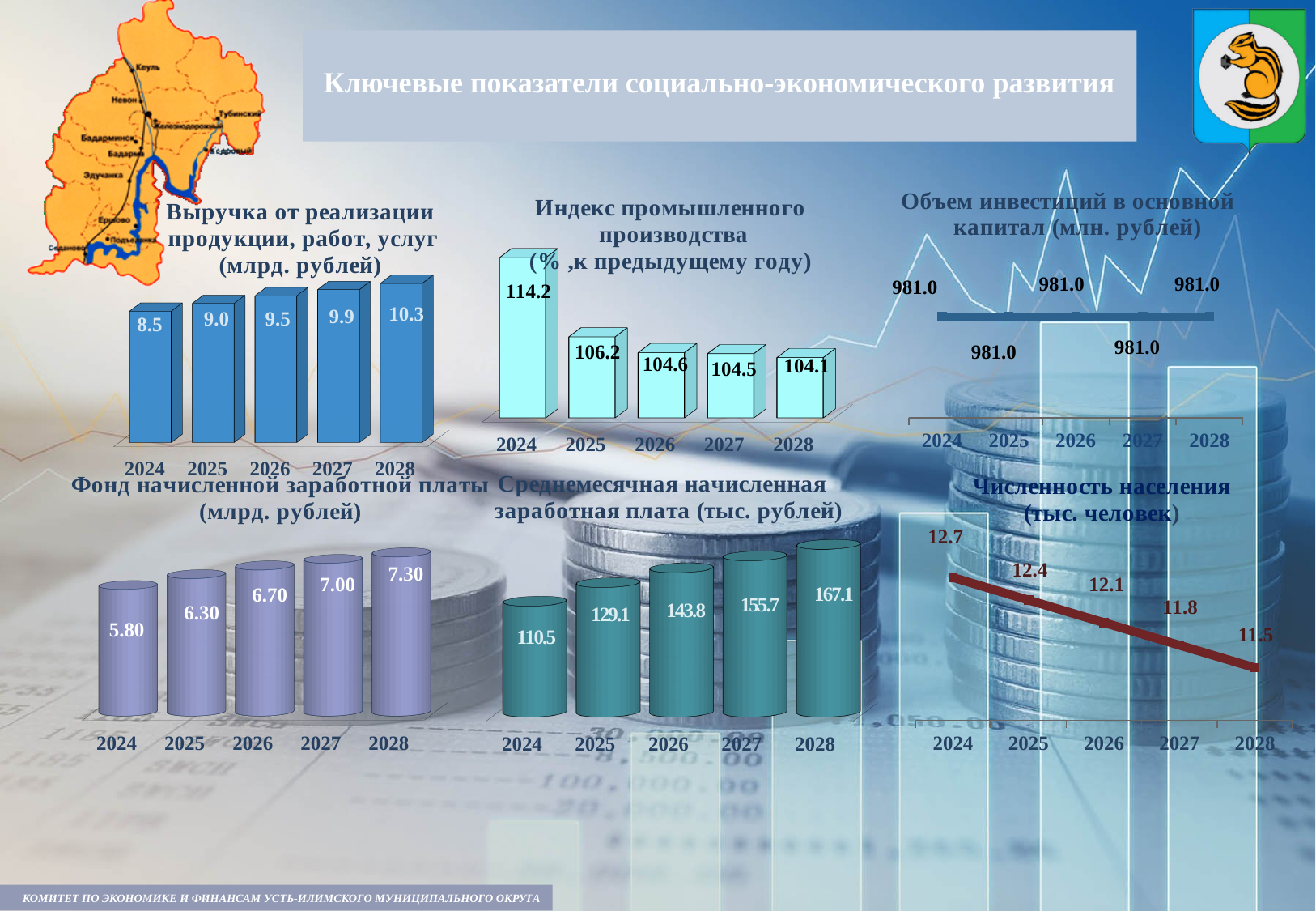
In the chart 'Фонд начисленной заработной платы (млрд. рублей)', what is the difference between the 2028 and 2024 values? 1.50 In the chart 'Индекс промышленного производства', do the values rise or fall from 2024 to 2028? fall In the chart 'Численность населения (тыс. человек)', what is the value for 2028? 11.5 In the chart 'Среднемесячная начисленная заработная плата (тыс. рублей)', what is the value for 2027? 155.7 In the chart 'Выручка от реализации продукции, работ, услуг (млрд. рублей)', what is the value for 2026? 9.5 In the chart 'Индекс промышленного производства', which year has the lowest value? 2028 In the chart 'Выручка от реализации продукции, работ, услуг (млрд. рублей)', which year has the highest value? 2028 In the chart 'Среднемесячная начисленная заработная плата (тыс. рублей)', which is larger, the value for 2025 or the value for 2026? 2026 In the chart 'Объем инвестиций в основной капитал (млн. рублей)', what is the value for 2027? 981.0 In the chart 'Фонд начисленной заработной платы (млрд. рублей)', how many years are shown? 5 In the chart 'Индекс промышленного производства', what is the value for 2024? 114.2 What kind of chart is 'Численность населения (тыс. человек)'? line chart